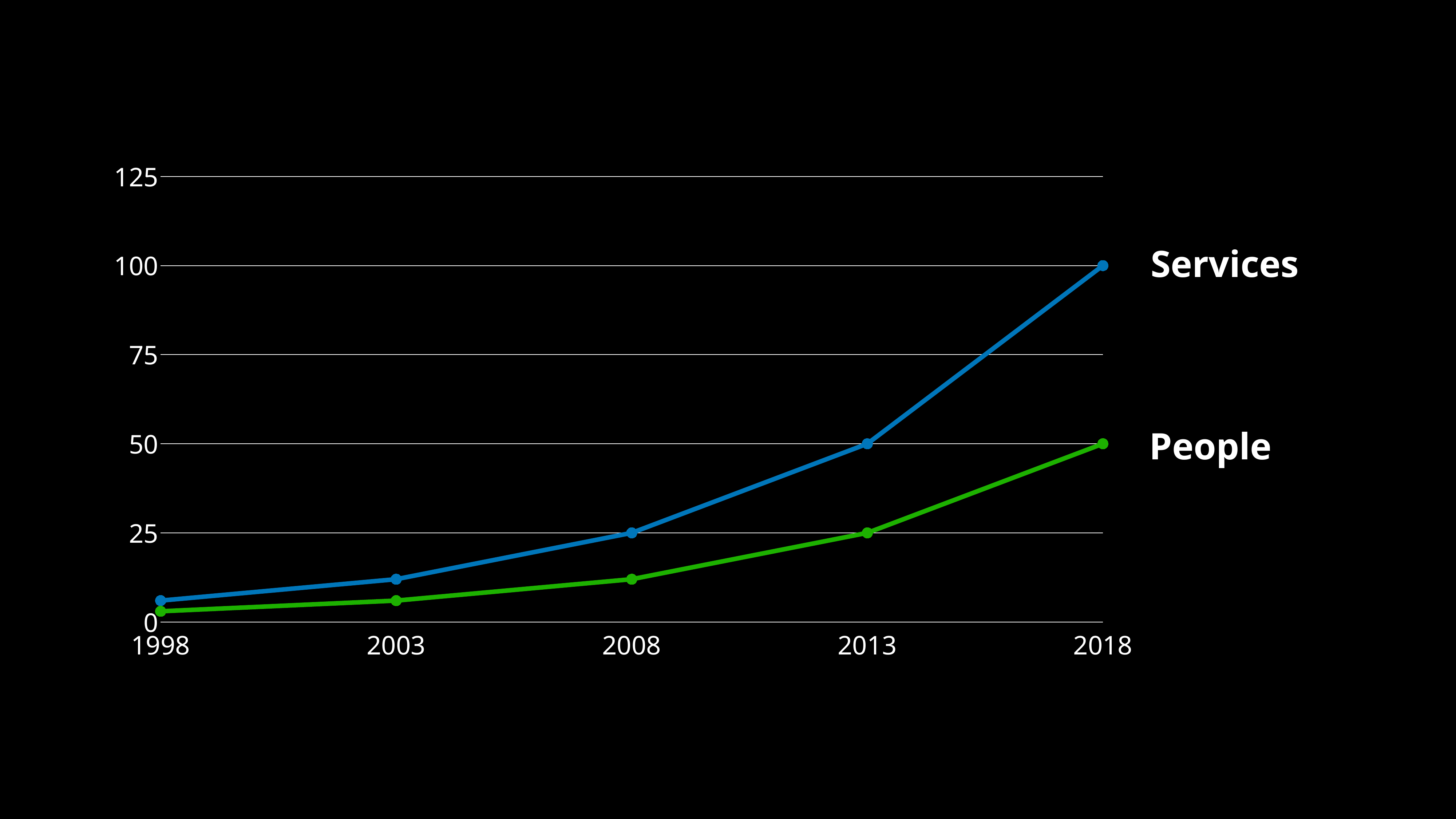
What is the value for Services in 2013? 50 What is the difference between Services and People in 2018? 50 What is the value for Services in 2018? 100 In which year does Services reach its highest value? 2018 Which series has the larger value in 2018, Services or People? Services Is the value for People in 2008 greater or less than 25? less What is the value for People in 2013? 25 How many series are plotted on the chart? 2 What is the value for People in 2018? 50 What type of chart is shown on the slide? Line chart Do the values for Services rise or fall from 1998 to 2018? Rise How many years are plotted along the x axis? 5